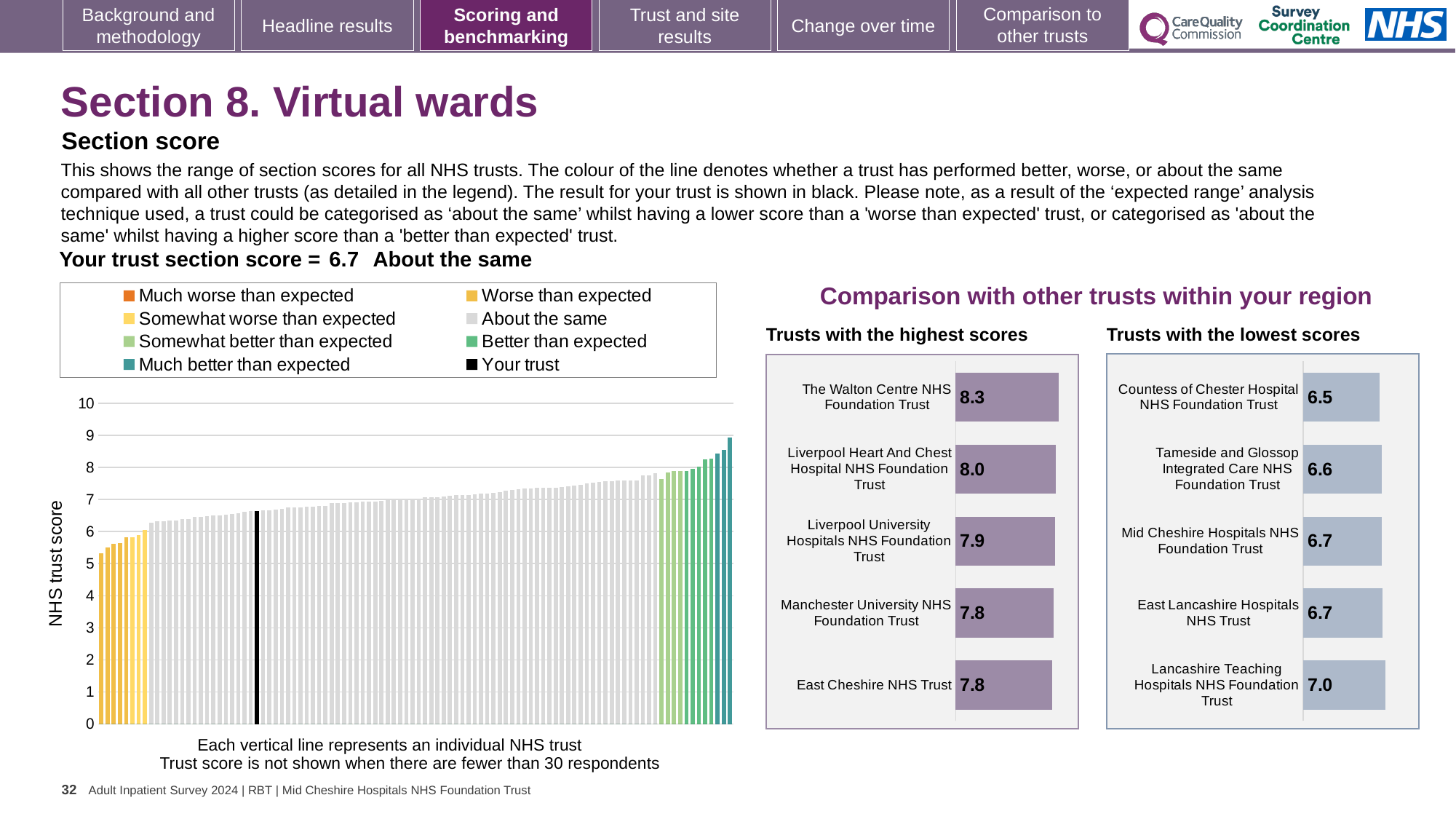
How many entries does the legend of the NHS trust score chart on the left list? 8 In the NHS trust score chart on the left, is the value of the tallest bar greater or less than 8? greater In the 'Trusts with the highest scores' chart, what is the score for The Walton Centre NHS Foundation Trust? 8.3 In the 'Trusts with the highest scores' chart, which trust has the highest score? The Walton Centre NHS Foundation Trust What kind of chart is the NHS trust score chart on the left of the slide? Bar chart In the 'Trusts with the lowest scores' chart, what is the score for Lancashire Teaching Hospitals NHS Foundation Trust? 7.0 In the 'Trusts with the lowest scores' chart, which trust has the lowest score? Countess of Chester Hospital NHS Foundation Trust In the 'Trusts with the highest scores' chart, which has the higher score: Liverpool Heart And Chest Hospital NHS Foundation Trust or Manchester University NHS Foundation Trust? Liverpool Heart And Chest Hospital NHS Foundation Trust How many trusts are shown in the 'Trusts with the lowest scores' chart? 5 In the NHS trust score chart on the left, what is the section score for your trust (the black bar)? 6.7 In the 'Trusts with the highest scores' chart, what is the difference between the scores of The Walton Centre NHS Foundation Trust and East Cheshire NHS Trust? 0.5 In the NHS trust score chart on the left, do the bar values rise or fall from left to right? Rise